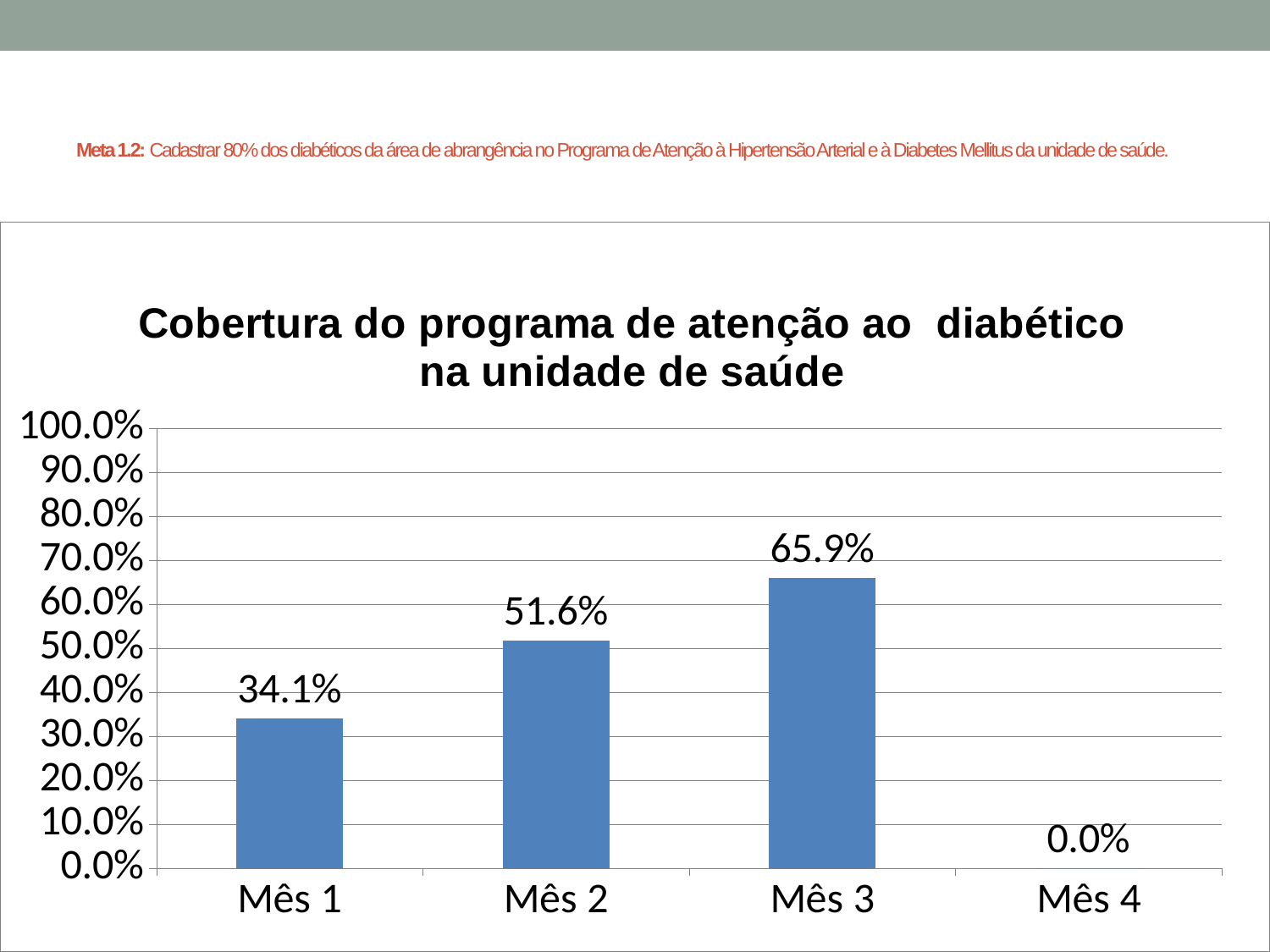
Which month has the highest value? Mês 3 What kind of chart is this? Bar chart What is the value for Mês 4? 0.0% Which is larger, the value for Mês 2 or the value for Mês 3? Mês 3 What is the title of the chart? Cobertura do programa de atenção ao diabético na unidade de saúde What is the difference between the values for Mês 3 and Mês 1? 31.8% Which month has the lowest value? Mês 4 What is the difference between the values for Mês 2 and Mês 1? 17.5% What is the value for Mês 1? 34.1% What is the value for Mês 3? 65.9% What is the value for Mês 2? 51.6% How many categories are shown on the x axis? 4